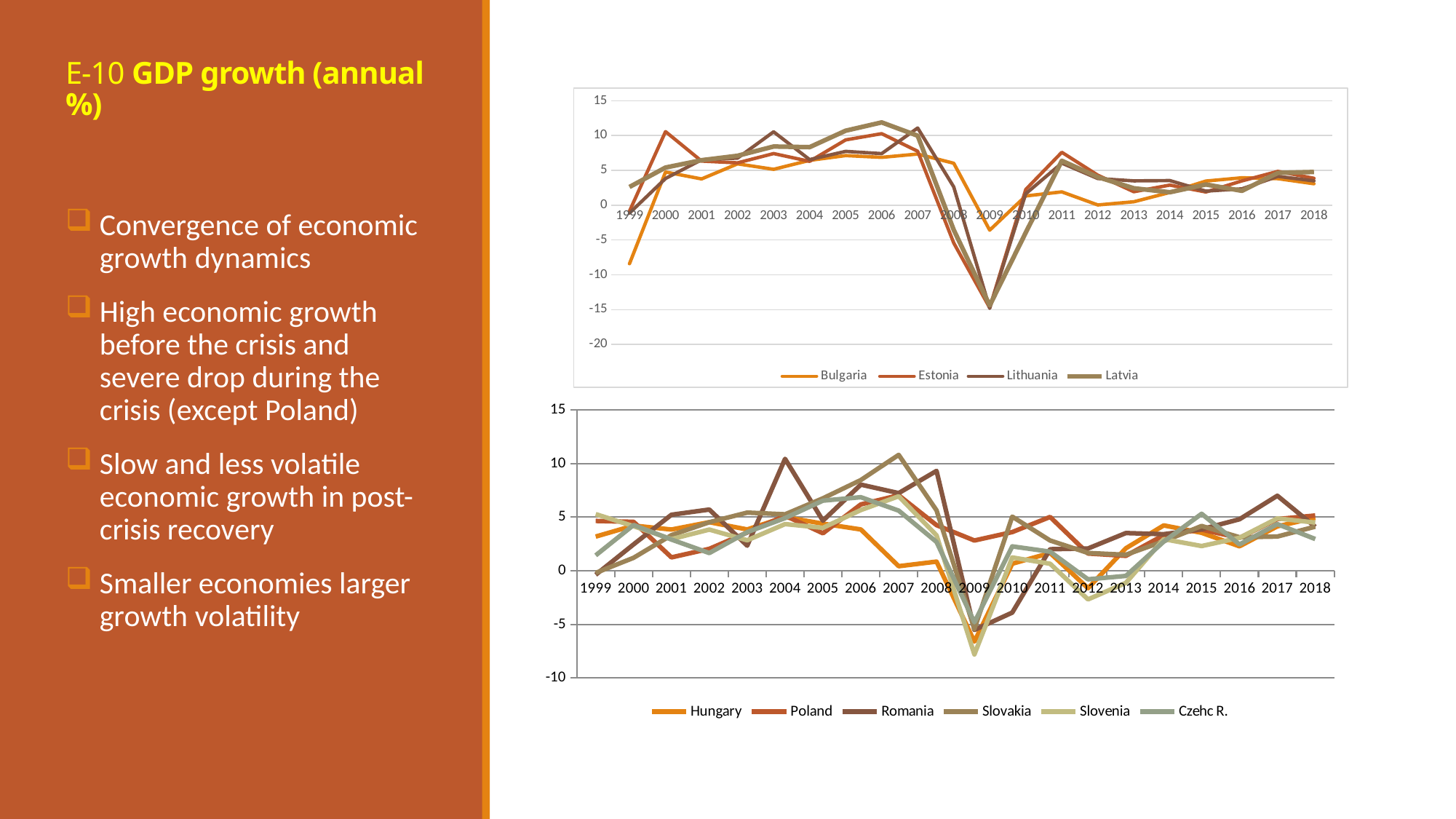
How many years are shown on the x axis of the bottom chart? 20 How many series does the legend of the top chart list? 4 In the top chart, which series has the lowest value in 1999? Bulgaria In the top chart, is the value for Latvia in 2006 greater or less than 10? greater Which series are listed in the legend of the bottom chart? Hungary, Poland, Romania, Slovakia, Slovenia, Czehc R. In the top chart, is the value for Latvia in 2009 greater or less than -10? less What kind of chart is the top chart on the slide? line chart In the bottom chart, is the value for Slovenia in 2009 greater or less than -5? less How many series does the legend of the bottom chart list? 6 In the top chart, does the Bulgaria line rise or fall from 2007 to 2009? fall In the bottom chart, which is larger in 2009, the value for Poland or the value for Slovenia? Poland